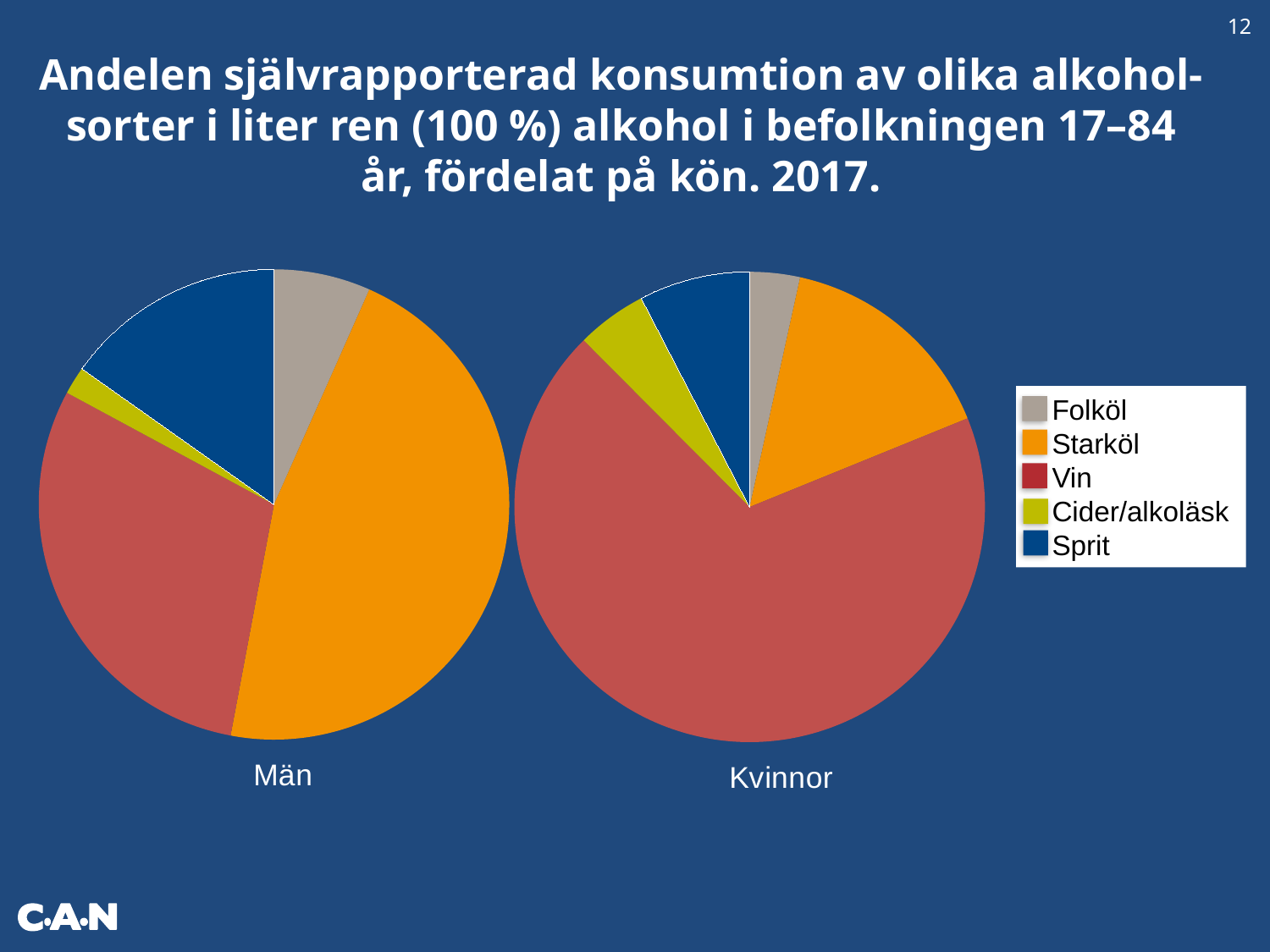
Which colour represents Vin in the legend of the pie charts? red In the Män pie chart, which category has the smallest slice? Cider/alkoläsk In the Män pie chart, which category has the largest slice? Starköl In the Män pie chart, which slice is larger, Sprit or Folköl? Sprit In the Män pie chart, which slice is larger, Starköl or Vin? Starköl In the Kvinnor pie chart, which slice is larger, Sprit or Cider/alkoläsk? Sprit How many slices does the Kvinnor pie chart have? 5 What is the label of the pie chart on the left side of the slide? Män What kind of chart is used for the Män chart? pie chart How many categories does the legend list for the pie charts? 5 In the Kvinnor pie chart, which category has the largest slice? Vin